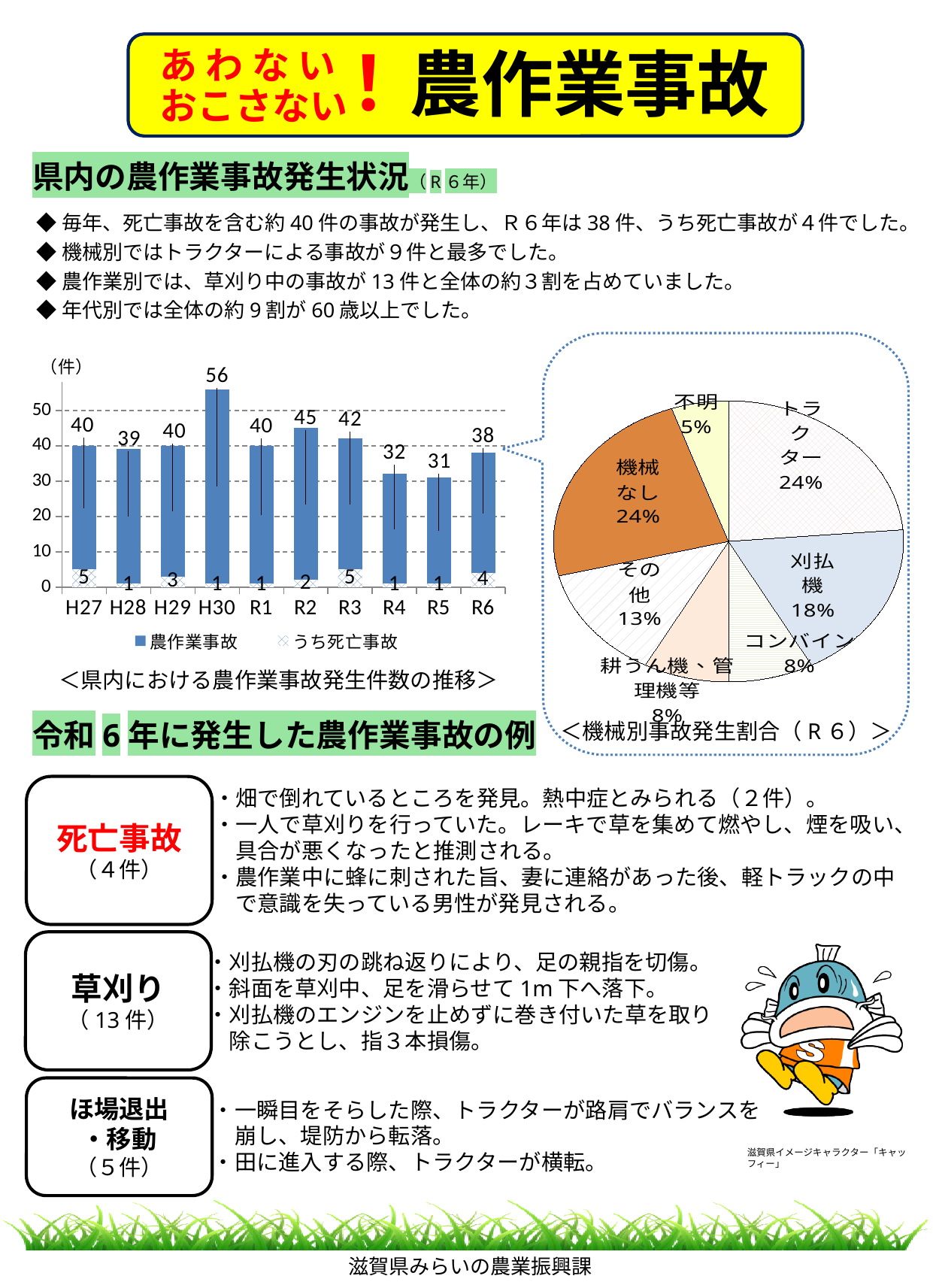
棒グラフ「県内における農作業事故発生件数の推移」で、R2とR3では農作業事故の件数はどちらが多いですか？ R2 棒グラフ「県内における農作業事故発生件数の推移」の凡例には、いくつの系列がありますか？ 2 棒グラフ「県内における農作業事故発生件数の推移」で、H30とR6の農作業事故件数の差はいくつですか？ 18 棒グラフ「県内における農作業事故発生件数の推移」で、R6の農作業事故の件数はいくつですか？ 38 円グラフ「機械別事故発生割合（R6）」で、コンバインの割合は何％ですか？ 8% 棒グラフ「県内における農作業事故発生件数の推移」で、農作業事故の件数が最も少ない年はどれですか？ R5 棒グラフ「県内における農作業事故発生件数の推移」には、何年分のデータがありますか？ 10 円グラフ「機械別事故発生割合（R6）」には、いくつの区分がありますか？ 7 棒グラフ「県内における農作業事故発生件数の推移」で、農作業事故の件数が最も多い年はどれですか？ H30 棒グラフ「県内における農作業事故発生件数の推移」で、H30のうち死亡事故の件数はいくつですか？ 1 円グラフ「機械別事故発生割合（R6）」で、刈払機の割合は何％ですか？ 18% 「県内における農作業事故発生件数の推移」はどの種類のグラフですか？ 棒グラフ